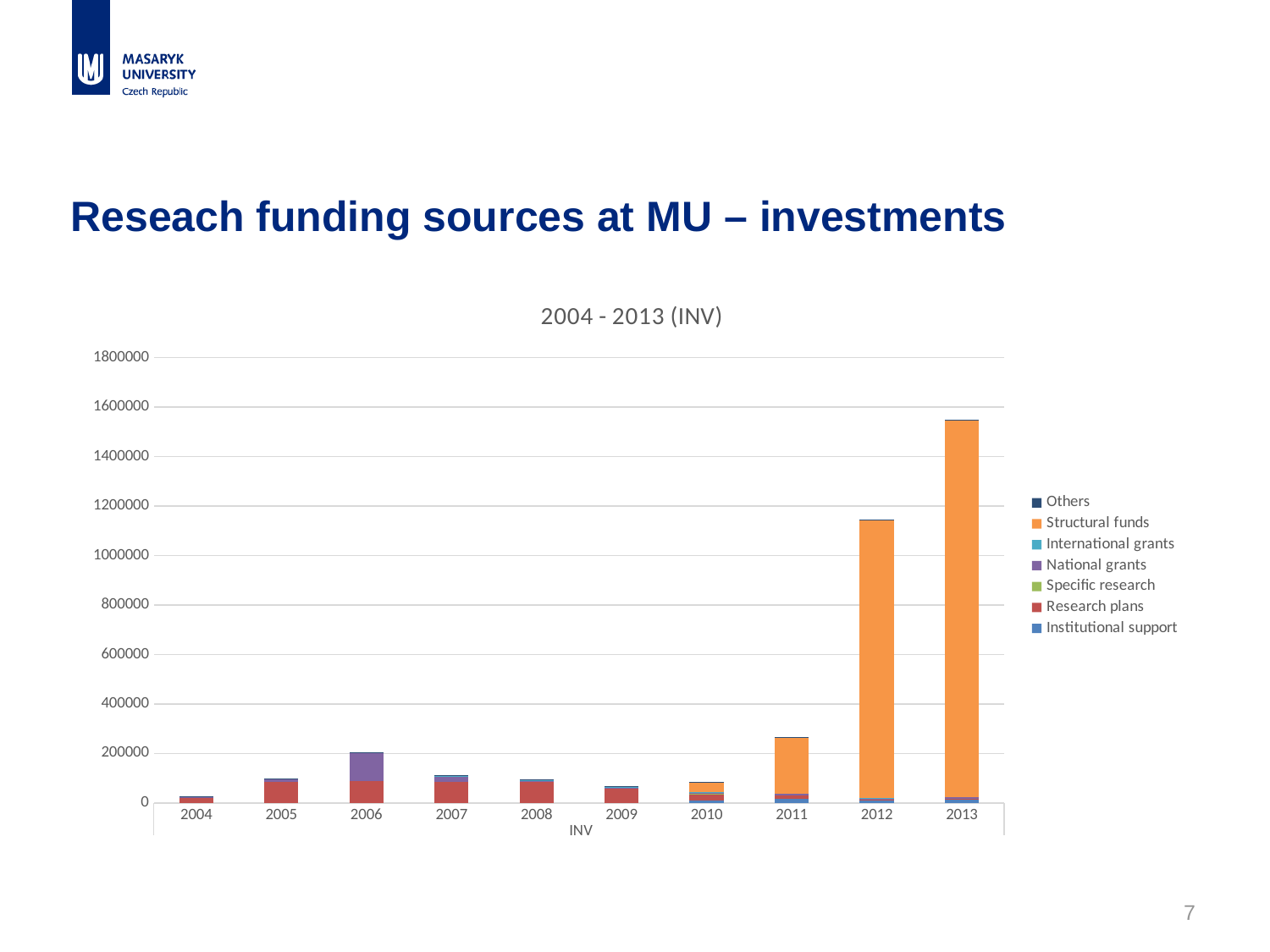
What is the title of the chart? 2004 - 2013 (INV) Which year has the larger total bar, 2011 or 2012? 2012 Is the total for 2012 greater or less than 1000000? greater Do the total bars rise or fall from 2010 to 2013? rise Is the total for 2009 greater or less than 200000? less Which year has the highest total bar? 2013 Is the total for 2013 greater or less than 1400000? greater How many years are shown on the x axis? 10 How many series does the legend list? 7 Which year has the lowest total bar? 2004 What kind of chart is shown on the slide? Stacked bar chart